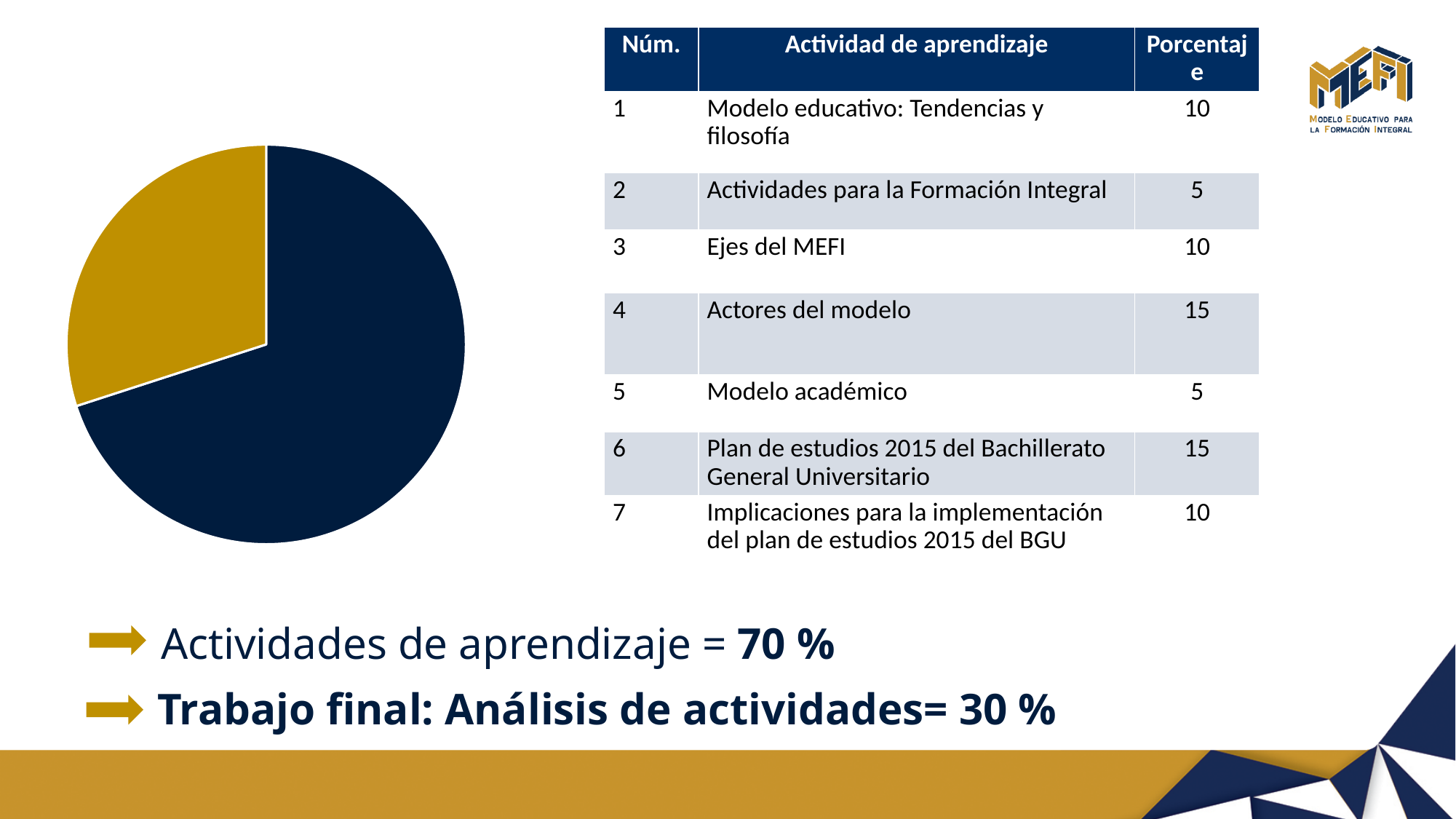
What is the difference in percentage points between the Actividades de aprendizaje share and the Trabajo final share? 40 Which slice of the pie chart is the smallest? the gold slice Does the pie chart display a legend? No Which slice of the pie chart is larger, the dark navy one or the gold one? the dark navy one According to the slide text, what share of the total does the Trabajo final: Análisis de actividades (the smaller slice) represent? 30 % Is the gold slice of the pie chart greater or less than half of the pie? less According to the slide text, what share of the total do the Actividades de aprendizaje (the larger slice) represent? 70 % Is the dark navy slice of the pie chart greater or less than half of the pie? greater What kind of chart is shown on the left of the slide? pie chart How many slices does the pie chart have? 2 What two colours are used for the slices of the pie chart? dark navy and gold